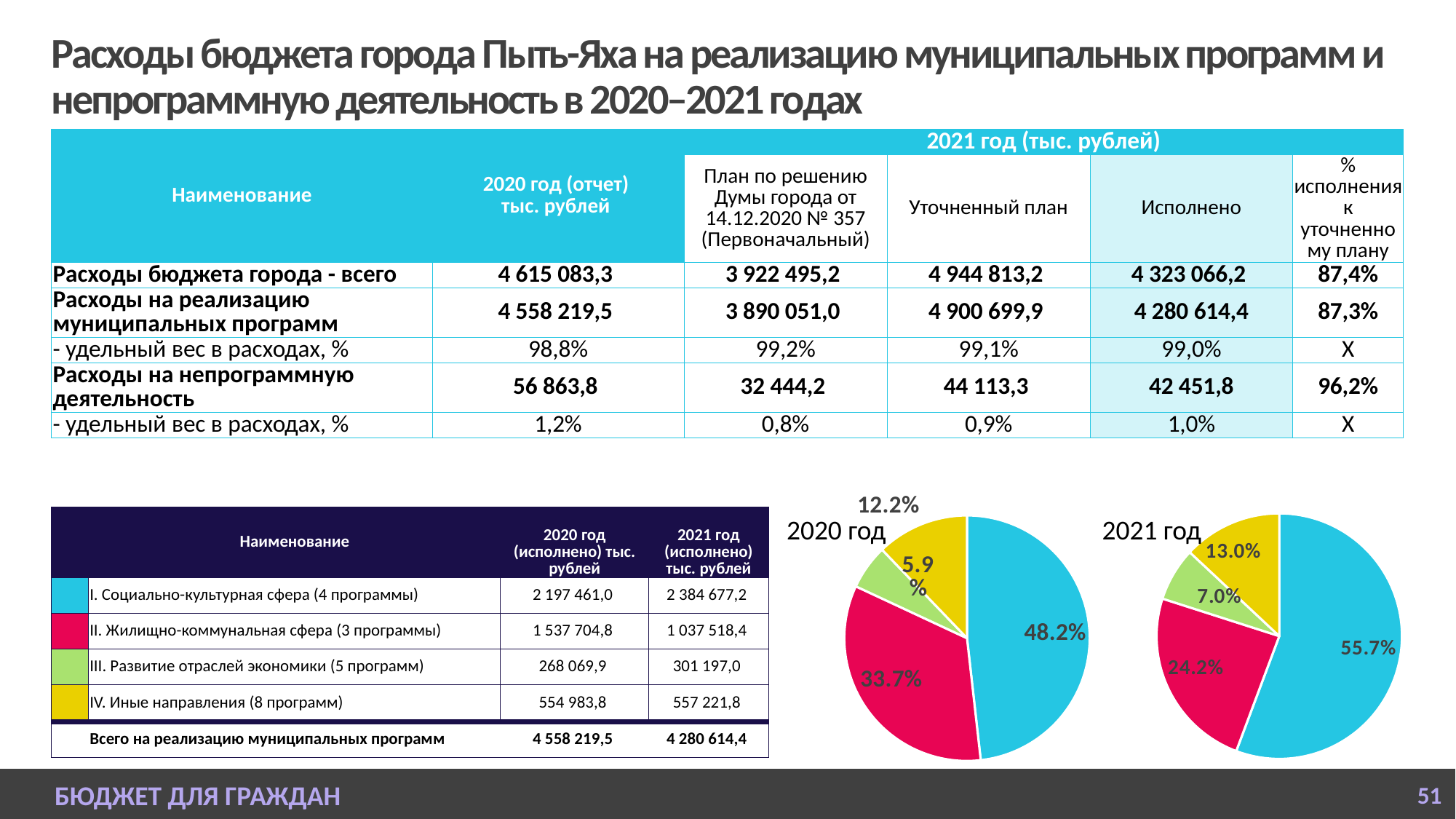
In the 2020 год pie chart, what share is shown for the red slice (Жилищно-коммунальная сфера)? 33.7% In the 2021 год pie chart, which slice is the smallest? Развитие отраслей экономики (7.0%) How many slices does each pie chart on the slide have? 4 In the 2020 год pie chart, what share is shown for the green slice (Развитие отраслей экономики)? 5.9% In the 2020 год pie chart, what share is shown for the largest slice (blue, Социально-культурная сфера)? 48.2% What is the difference between the blue slice's share in the 2021 год pie chart and in the 2020 год pie chart? 7.5% Which is larger: the red slice in the 2020 год pie chart or the red slice in the 2021 год pie chart? 2020 год (33.7%) What type of charts are shown at the bottom right of the slide? Pie charts In the 2020 год pie chart, which slice is the largest? Социально-культурная сфера (48.2%)